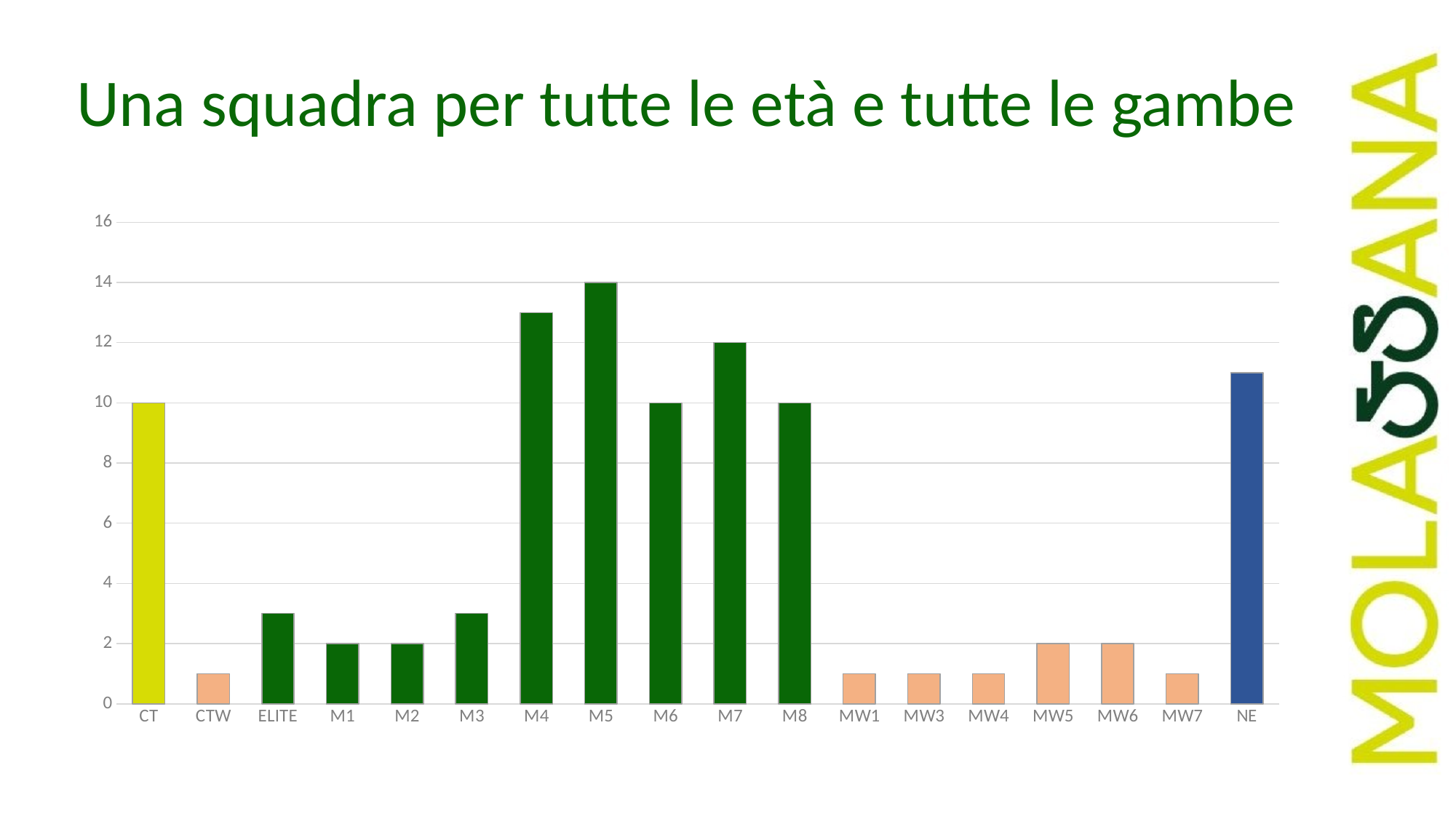
What is the value for M6? 10 Which category has the highest bar in the chart? M5 What is the difference between the values for M6 and M1? 8 Is the value for NE greater or less than 10? greater Is the value for M5 greater or less than 12? greater What is the value for CT? 10 Which is larger, the value for M7 or the value for M8? M7 What type of chart is shown on the slide? bar chart How many categories are shown on the x axis of the chart? 18 Is the value for CTW greater or less than 2? less What is the value for M1? 2 What is the value for MW5? 2